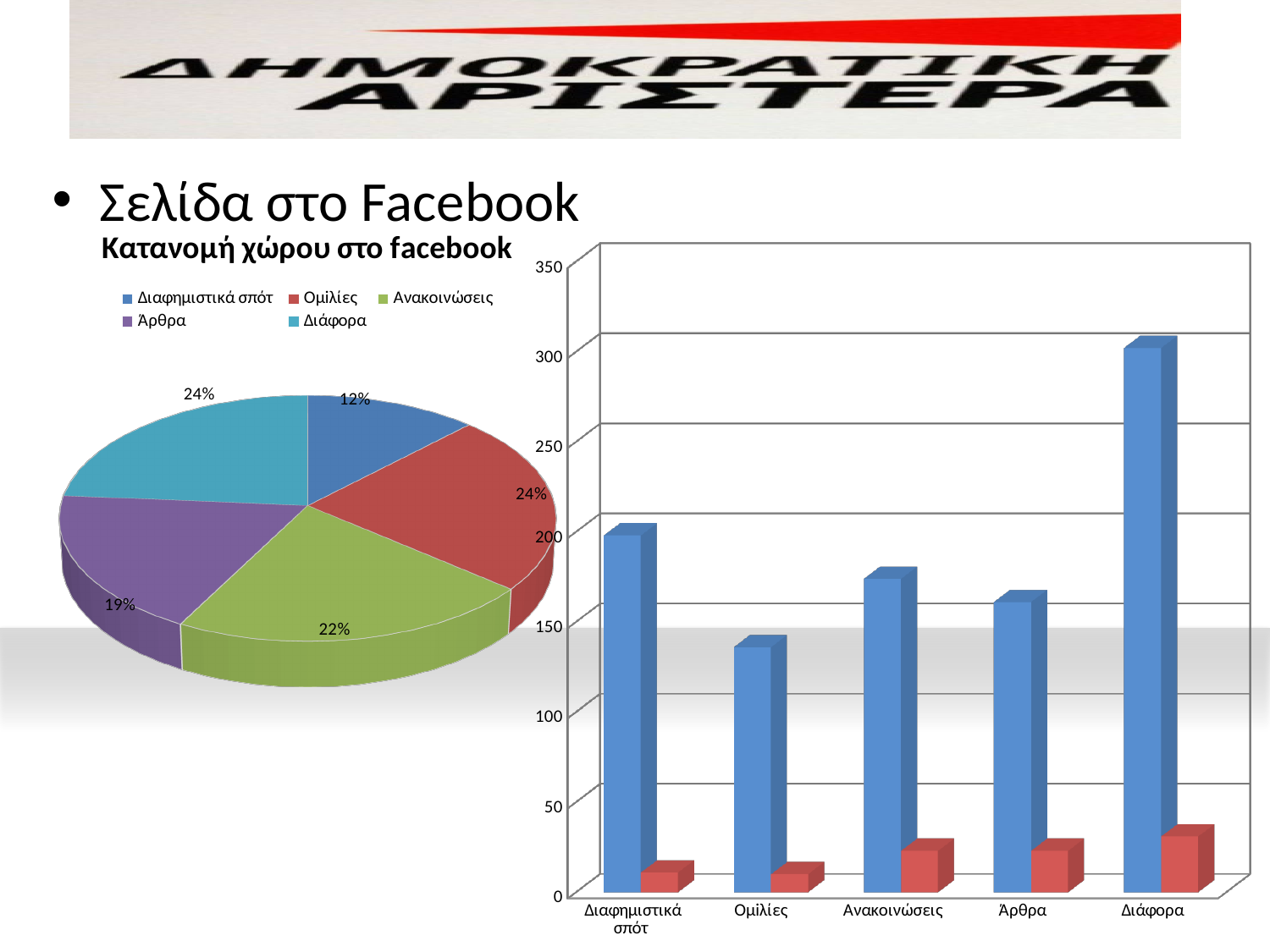
What kind of chart is the chart on the right of the slide? Bar chart In the pie chart titled 'Κατανομή χώρου στο facebook', what share does Ανακοινώσεις have? 22% In the bar chart on the right, is the blue bar for Ομιλίες greater or less than 150? less In the pie chart titled 'Κατανομή χώρου στο facebook', which category has the smallest share? Διαφημιστικά σπότ What kind of chart is the chart on the left of the slide? Pie chart In the pie chart titled 'Κατανομή χώρου στο facebook', what share does Διαφημιστικά σπότ have? 12% In the bar chart on the right, is the blue bar for Διάφορα greater or less than 250? greater In the pie chart titled 'Κατανομή χώρου στο facebook', what share does Άρθρα have? 19% In the bar chart on the right, which category has the shortest blue bar? Ομιλίες In the pie chart titled 'Κατανομή χώρου στο facebook', how many categories does the legend list? 5 In the pie chart titled 'Κατανομή χώρου στο facebook', how many percentage points larger is the share of Διάφορα than the share of Διαφημιστικά σπότ? 12% In the bar chart on the right, which category has the tallest blue bar? Διάφορα